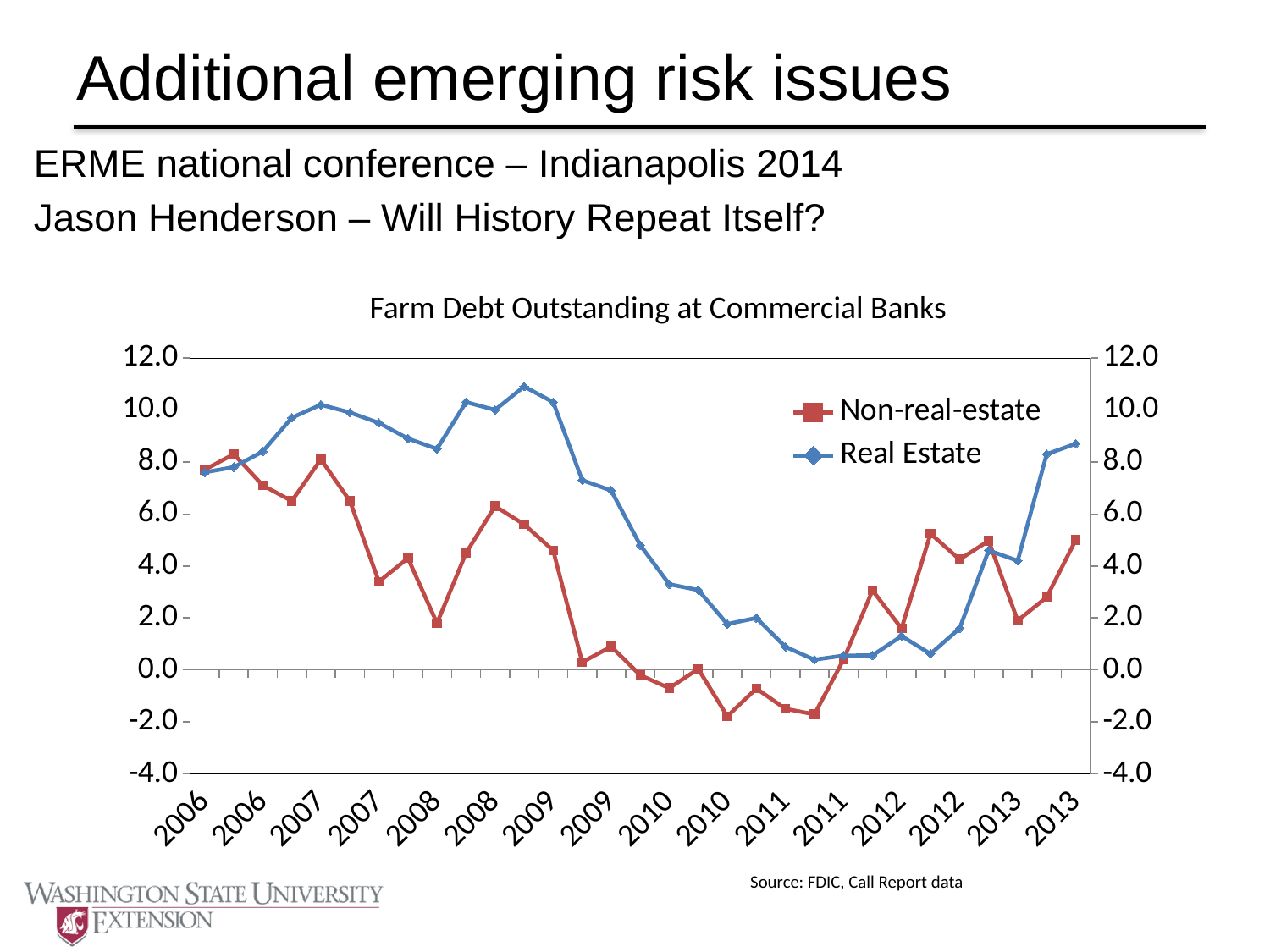
Is the Real Estate value at the last 2013 point greater or less than 8.0? greater Does the Real Estate series rise or fall between 2009 and 2011? Fall How many series does the legend list? 2 What is the title of the chart? Farm Debt Outstanding at Commercial Banks At the second 2012 point, which series has the larger value, Non-real-estate or Real Estate? Non-real-estate Is the peak value of the Real Estate series around 2009 greater or less than 10.0? greater Is the lowest value of the Non-real-estate series around 2010 greater or less than 0.0? less Which series reaches the highest value anywhere on the chart? Real Estate At the first 2009 point, which series has the larger value, Real Estate or Non-real-estate? Real Estate Which series is drawn with red square markers? Non-real-estate What kind of chart is shown on the slide? Line chart